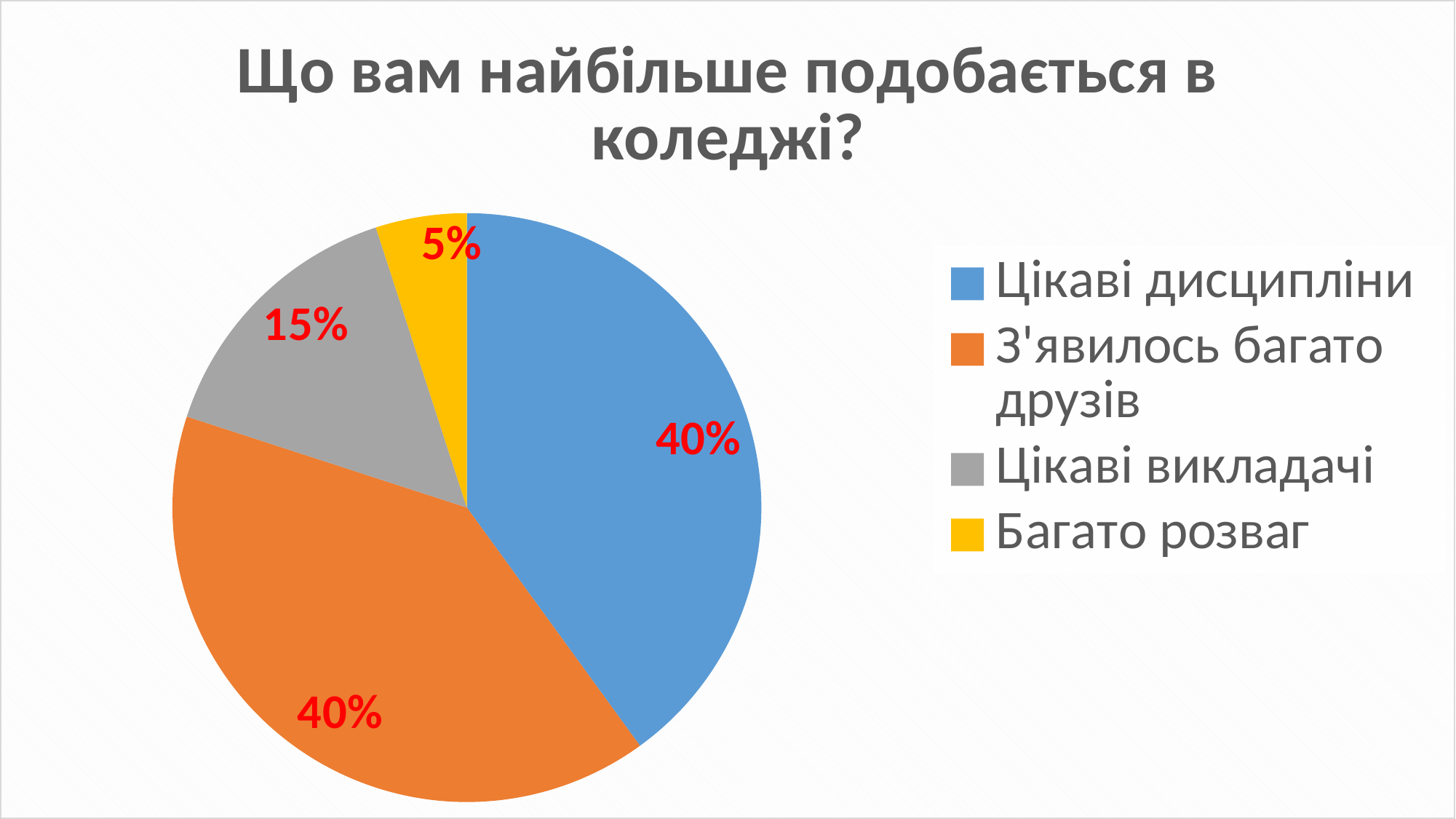
How many categories does the pie chart show? 4 What percentage is shown for Багато розваг? 5% Which category has the smallest slice of the pie? Багато розваг What is the difference between the shares for Цікаві дисципліни and Цікаві викладачі? 25% What is the title of the chart? Що вам найбільше подобається в коледжі? What is the difference between the shares for Цікаві викладачі and Багато розваг? 10% What value is printed on the slice for Цікаві викладачі? 15% Which is larger, the slice for Цікаві викладачі or the slice for Багато розваг? Цікаві викладачі What percentage of the pie is labelled for Цікаві дисципліни? 40% What kind of chart is shown on the slide? Pie chart Which is larger, the slice for З'явилось багато друзів or the slice for Цікаві викладачі? З'явилось багато друзів What share does the slice for З'явилось багато друзів show? 40%